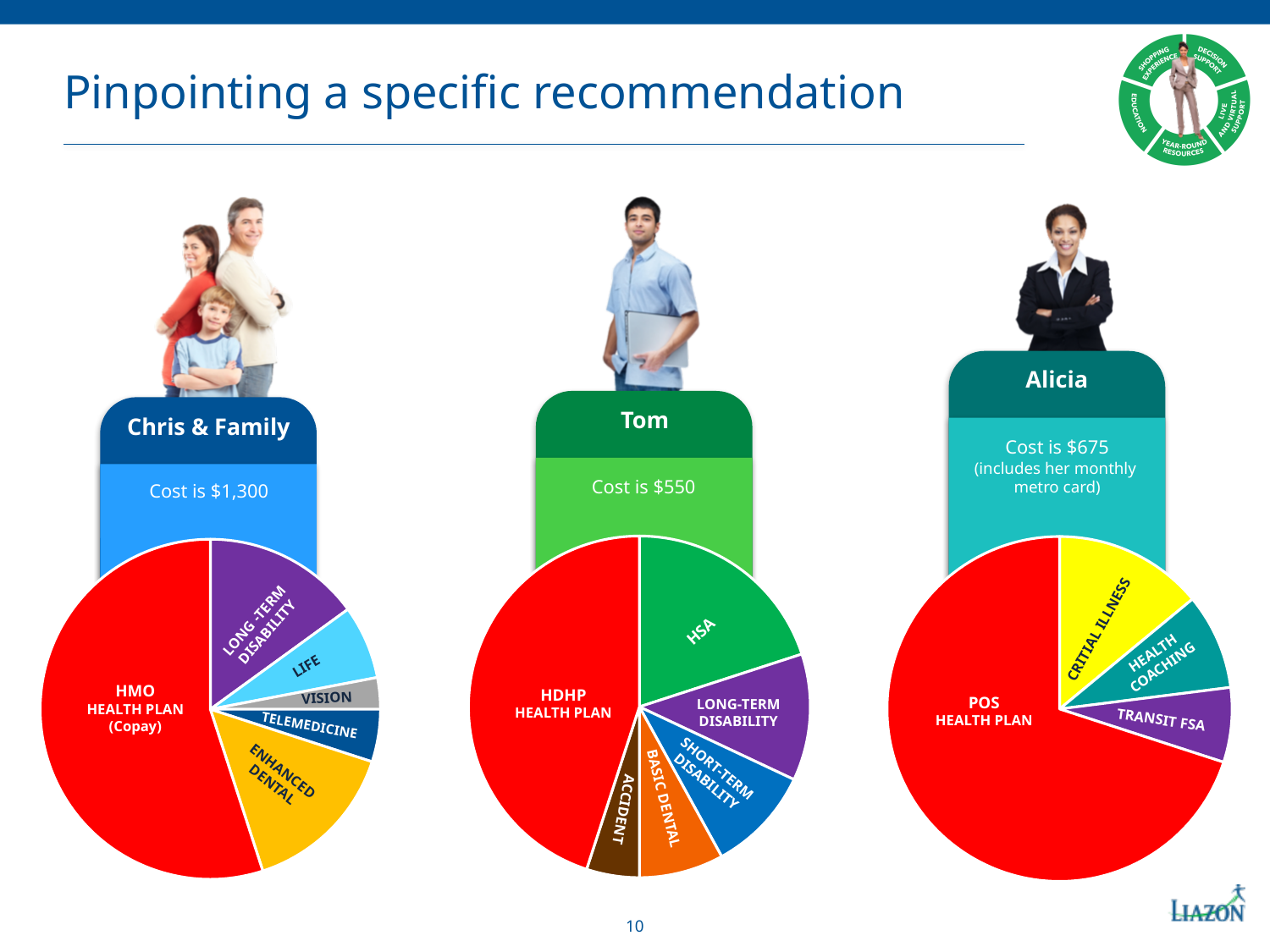
In the Chris & Family pie chart, which slice is larger, Enhanced Dental or Life? Enhanced Dental In the Tom pie chart, which slice is larger, HSA or Long-Term Disability? HSA What cost is shown above the Tom pie chart? $550 In the Alicia pie chart, how many slices are there? 4 In the Alicia pie chart, which slice is the largest? POS Health Plan In the Chris & Family pie chart, how many slices are there? 6 In the Alicia pie chart, which slice is larger, Critical Illness or Transit FSA? Critical Illness In the Chris & Family pie chart, which slice is the largest? HMO Health Plan (Copay) How many pie charts are on the slide? 3 In the Tom pie chart, which slice is the largest? HDHP Health Plan What kind of chart is shown under Chris & Family? Pie chart